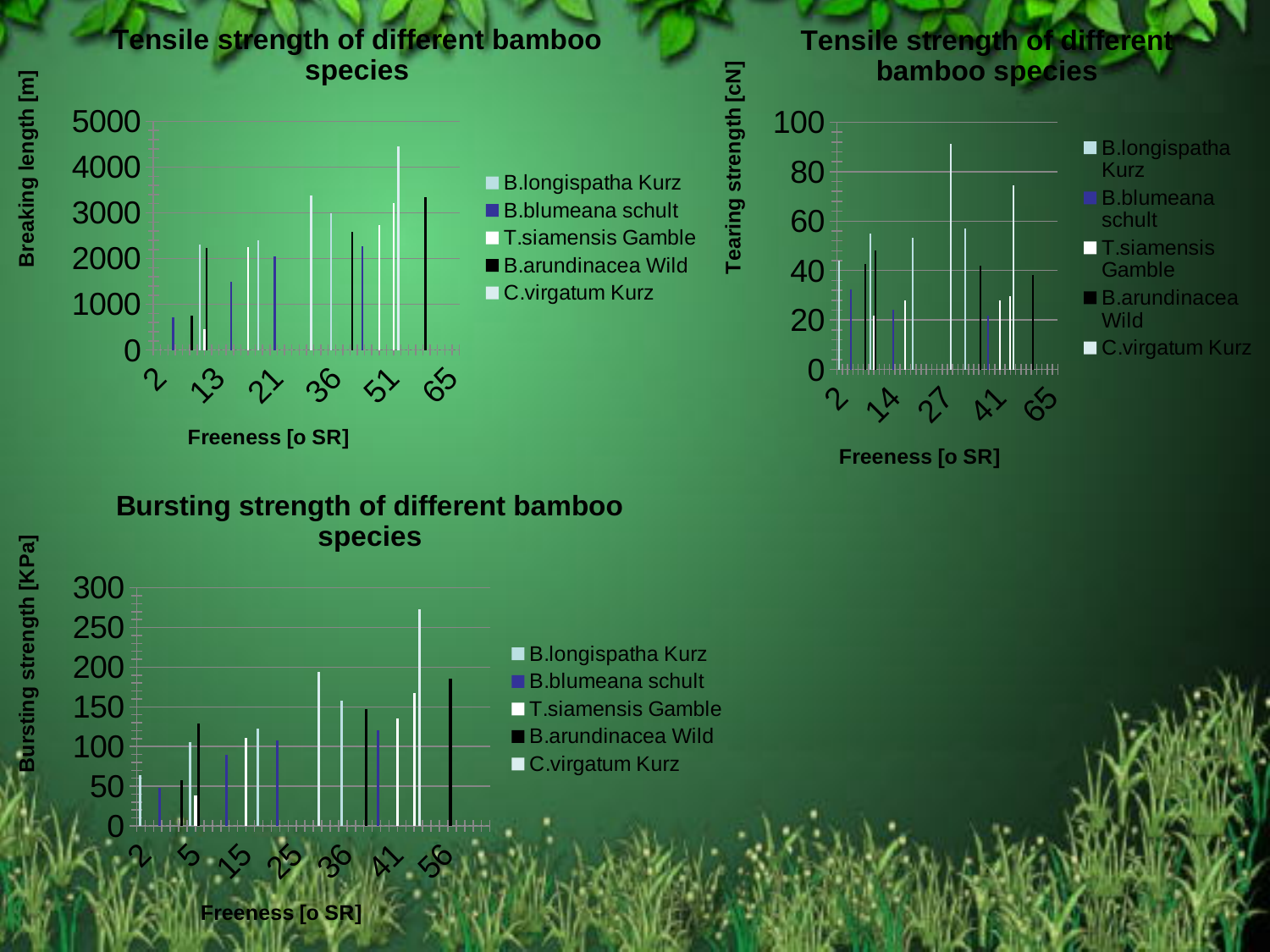
How many series does the legend of the top-right chart (Tearing strength) list? 5 What is the y-axis title of the top-left chart? Breaking length [m] What kind of chart is the bottom-left chart titled 'Bursting strength of different bamboo species'? bar chart In the bottom-left chart (Bursting strength), is the value of the tallest bar greater or less than 250? greater In the top-left chart (Breaking length), is the value of the tallest bar greater or less than 4000? greater How many series does the legend of the top-left chart (Breaking length) list? 5 What is the y-axis title of the top-right chart titled 'Tensile strength of different bamboo species'? Tearing strength [cN] What kind of chart is the top-left chart titled 'Tensile strength of different bamboo species'? bar chart What is the x-axis title of the bottom-left chart (Bursting strength)? Freeness [o SR] In the top-right chart (Tearing strength), is the value of the tallest bar greater or less than 80? greater How many series does the legend of the bottom-left chart (Bursting strength) list? 5